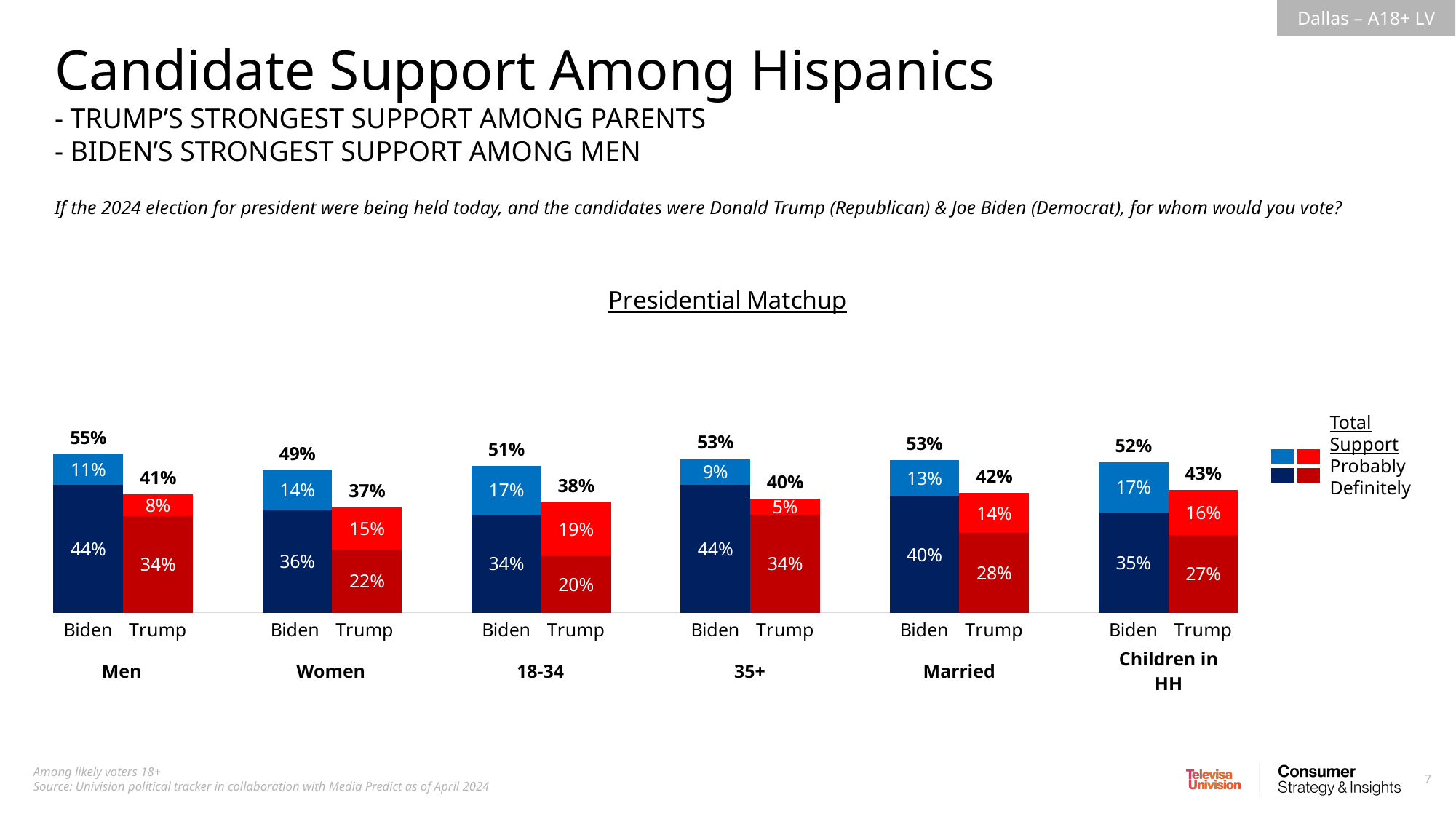
What is Biden's 'Probably' support in the 18-34 group? 17% What is the total of Trump's 'Probably' and 'Definitely' support among Married voters? 42% What is the difference between Biden's and Trump's total support among Men? 14% In which demographic group is Biden's total support lowest? Women What kind of chart is shown on the slide? Stacked bar chart What is Biden's total support among Men? 55% What is Trump's total support among those with Children in HH? 43% What is Trump's 'Definitely' support among Women? 22% Among the 35+ group, who has higher total support, Biden or Trump? Biden What is the title of the chart? Presidential Matchup In which demographic group is Trump's total support highest? Children in HH How many demographic groups are shown on the chart? 6